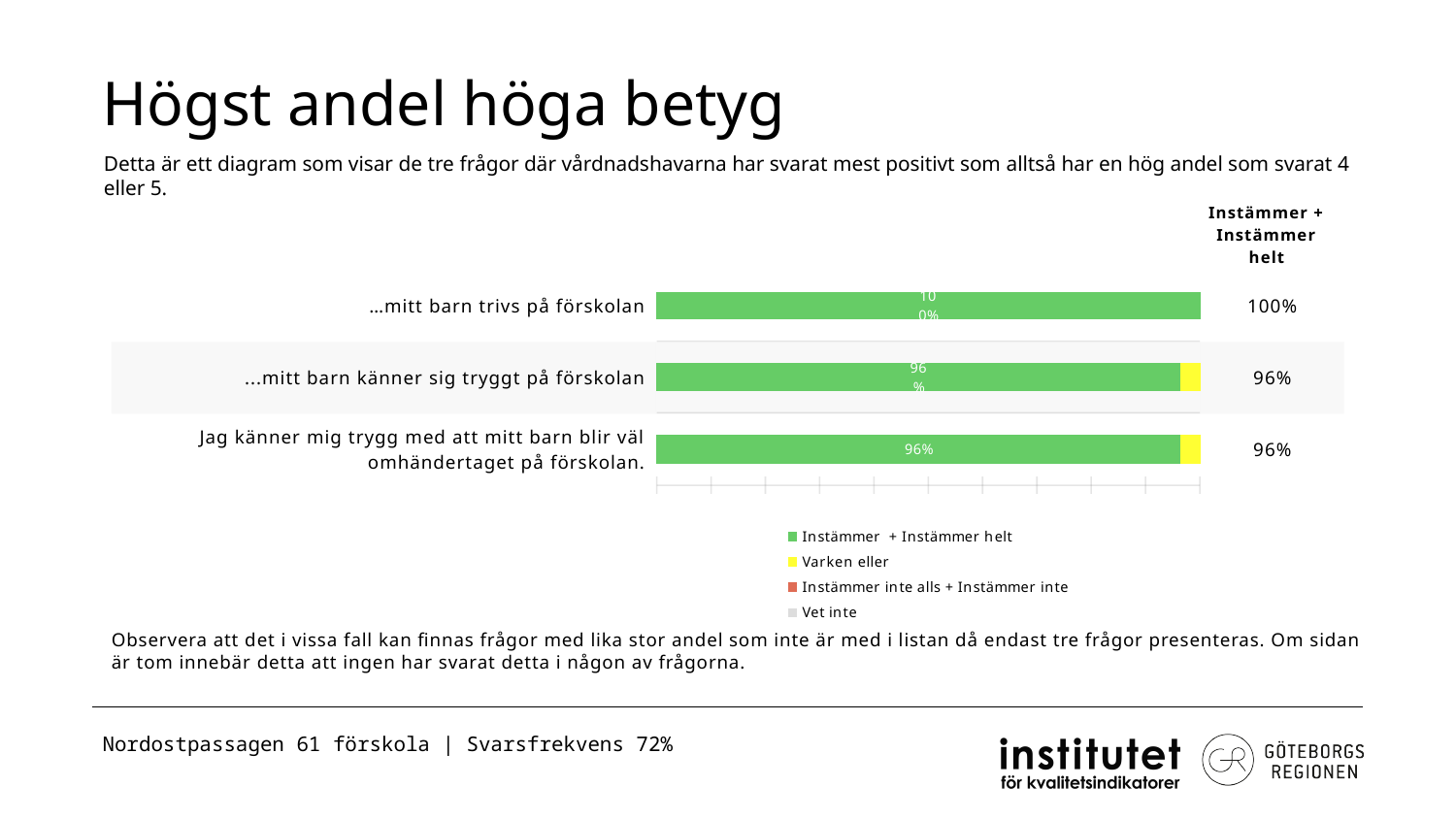
How many questions (categories) are shown in the chart? 3 Which question has the highest share of 'Instämmer + Instämmer helt'? …mitt barn trivs på förskolan How many series does the legend list? 4 What is the share of 'Instämmer + Instämmer helt' for 'Jag känner mig trygg med att mitt barn blir väl omhändertaget på förskolan.'? 96% What kind of chart is shown on the slide? Stacked bar chart What is the share of 'Instämmer + Instämmer helt' for '…mitt barn trivs på förskolan'? 100% Is the 'Instämmer + Instämmer helt' share for '...mitt barn känner sig tryggt på förskolan' greater or less than 50%? greater Which has a larger 'Instämmer + Instämmer helt' share: '…mitt barn trivs på förskolan' or 'Jag känner mig trygg med att mitt barn blir väl omhändertaget på förskolan.'? …mitt barn trivs på förskolan What is the difference in percentage points between the 'Instämmer + Instämmer helt' share for '…mitt barn trivs på förskolan' and for '...mitt barn känner sig tryggt på förskolan'? 4 percentage points Which colour represents 'Varken eller' in the legend? Yellow What is the share of 'Instämmer + Instämmer helt' for '...mitt barn känner sig tryggt på förskolan'? 96% What is the title of the slide containing the chart? Högst andel höga betyg